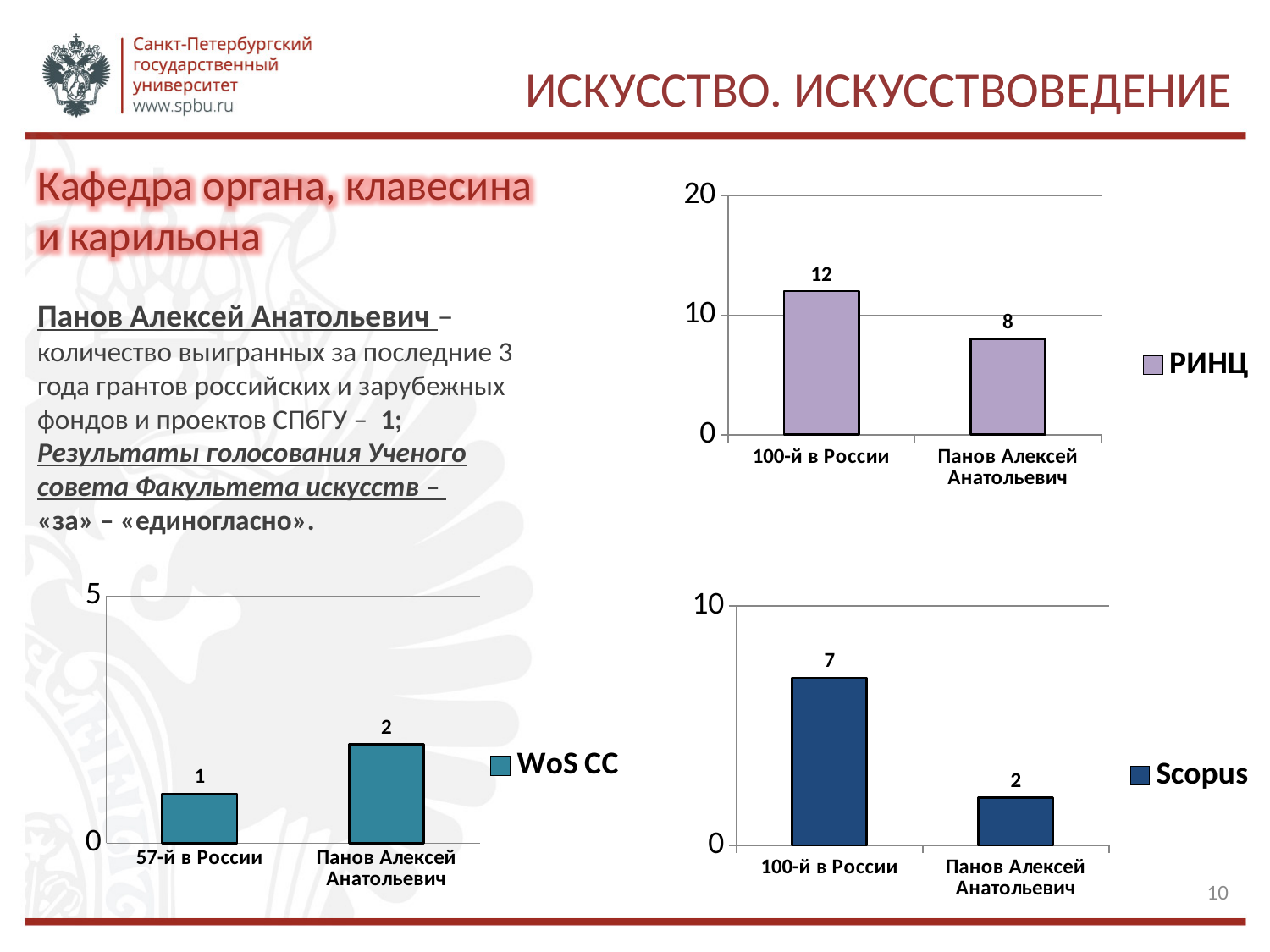
In the Scopus chart, what is the difference between the values for 100-й в России and Панов Алексей Анатольевич? 5 In the РИНЦ chart, what is the difference between the values for 100-й в России and Панов Алексей Анатольевич? 4 In the Scopus chart, what is the value for Панов Алексей Анатольевич? 2 In the WoS CC chart, what is the value for 57-й в России? 1 In the Scopus chart, which category has the lower value? Панов Алексей Анатольевич In the WoS CC chart, which category has the higher value? Панов Алексей Анатольевич How many categories are shown in the WoS CC chart? 2 In the Scopus chart, what is the value for 100-й в России? 7 In the WoS CC chart, what is the value for Панов Алексей Анатольевич? 2 In the РИНЦ chart, what is the value for Панов Алексей Анатольевич? 8 What kind of chart is the РИНЦ chart? bar chart In the РИНЦ chart, what is the value for 100-й в России? 12